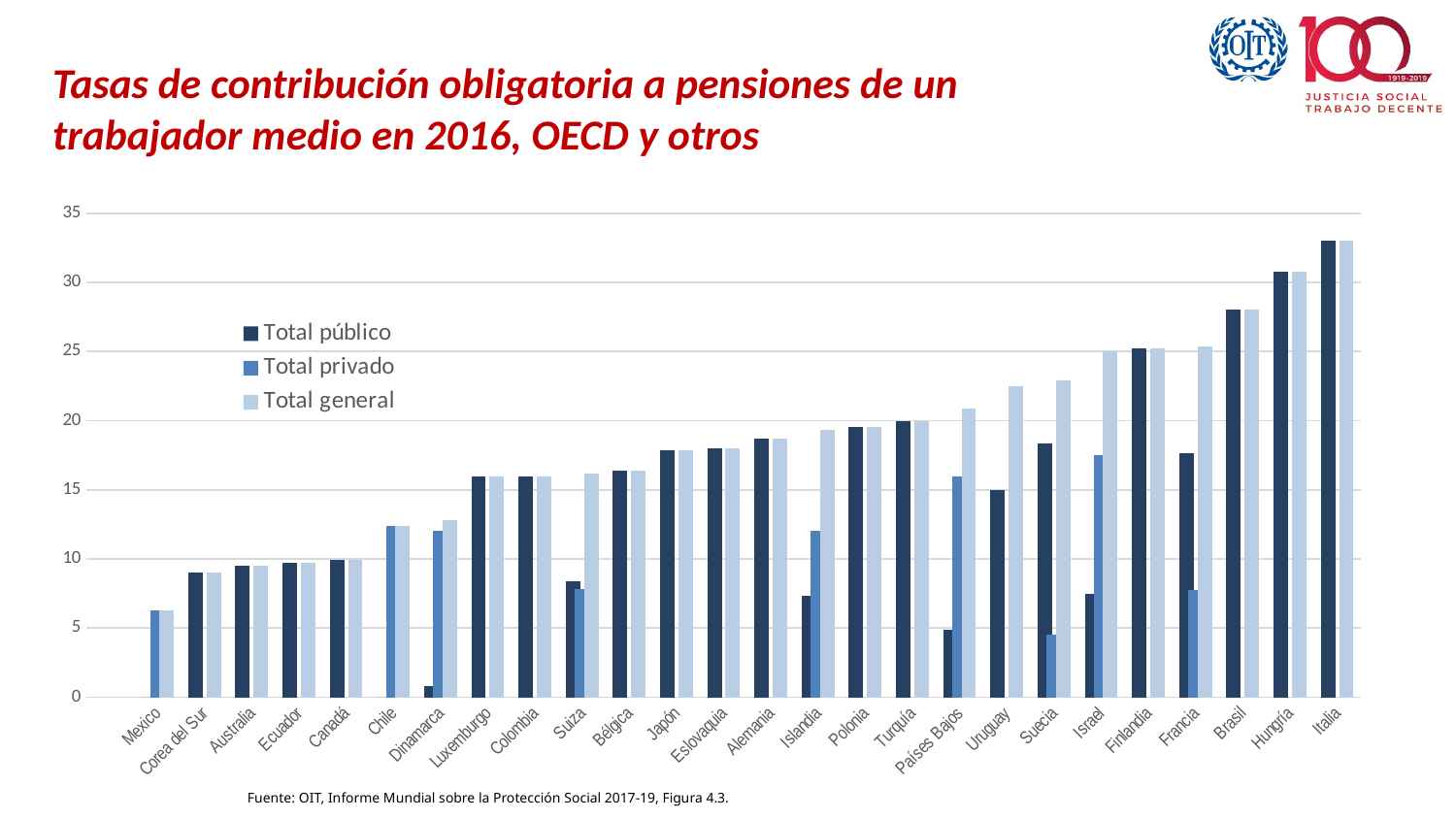
How many series does the legend list? 3 Is the Total privado value for Suecia greater or less than 5? less What are the three series listed in the legend? Total público, Total privado, Total general Do the Total general values rise or fall moving from left to right along the x axis? rise Which country has the lowest Total general value? Mexico How many countries are shown on the x axis? 26 Is the Total privado value for Chile greater or less than 10? greater Which is larger, the Total privado value for Países Bajos or for Suecia? Países Bajos Is the Total público value for Israel greater or less than 10? less Which country has the highest Total general value? Italia What kind of chart is shown on the slide? bar chart